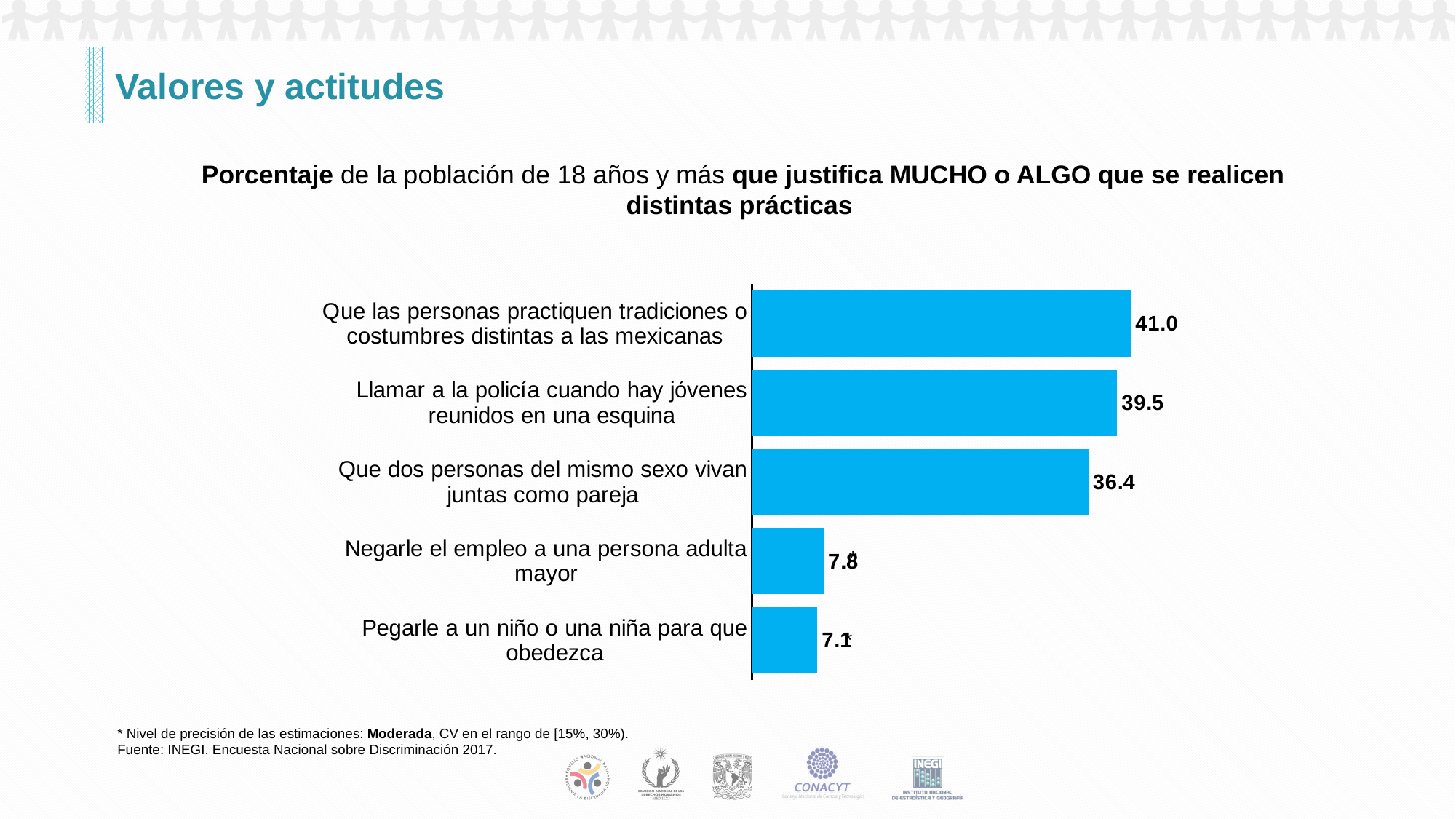
How many categories (practices) are shown in the chart? 5 Which is larger: the value for "Que dos personas del mismo sexo vivan juntas como pareja" or the value for "Negarle el empleo a una persona adulta mayor"? Que dos personas del mismo sexo vivan juntas como pareja What is the value for "Que las personas practiquen tradiciones o costumbres distintas a las mexicanas"? 41.0 What is the source cited for the chart data? INEGI. Encuesta Nacional sobre Discriminación 2017. Which practice has the highest percentage? Que las personas practiquen tradiciones o costumbres distintas a las mexicanas What is the difference between the values for "Que las personas practiquen tradiciones o costumbres distintas a las mexicanas" and "Llamar a la policía cuando hay jóvenes reunidos en una esquina"? 1.5 What type of chart is shown on the slide? bar chart What is the value for "Llamar a la policía cuando hay jóvenes reunidos en una esquina"? 39.5 What is the value for "Que dos personas del mismo sexo vivan juntas como pareja"? 36.4 Which practice has the lowest percentage? Pegarle a un niño o una niña para que obedezca What is the difference between the values for "Que las personas practiquen tradiciones o costumbres distintas a las mexicanas" and "Que dos personas del mismo sexo vivan juntas como pareja"? 4.6 Is the value for "Negarle el empleo a una persona adulta mayor" greater or less than 10? less